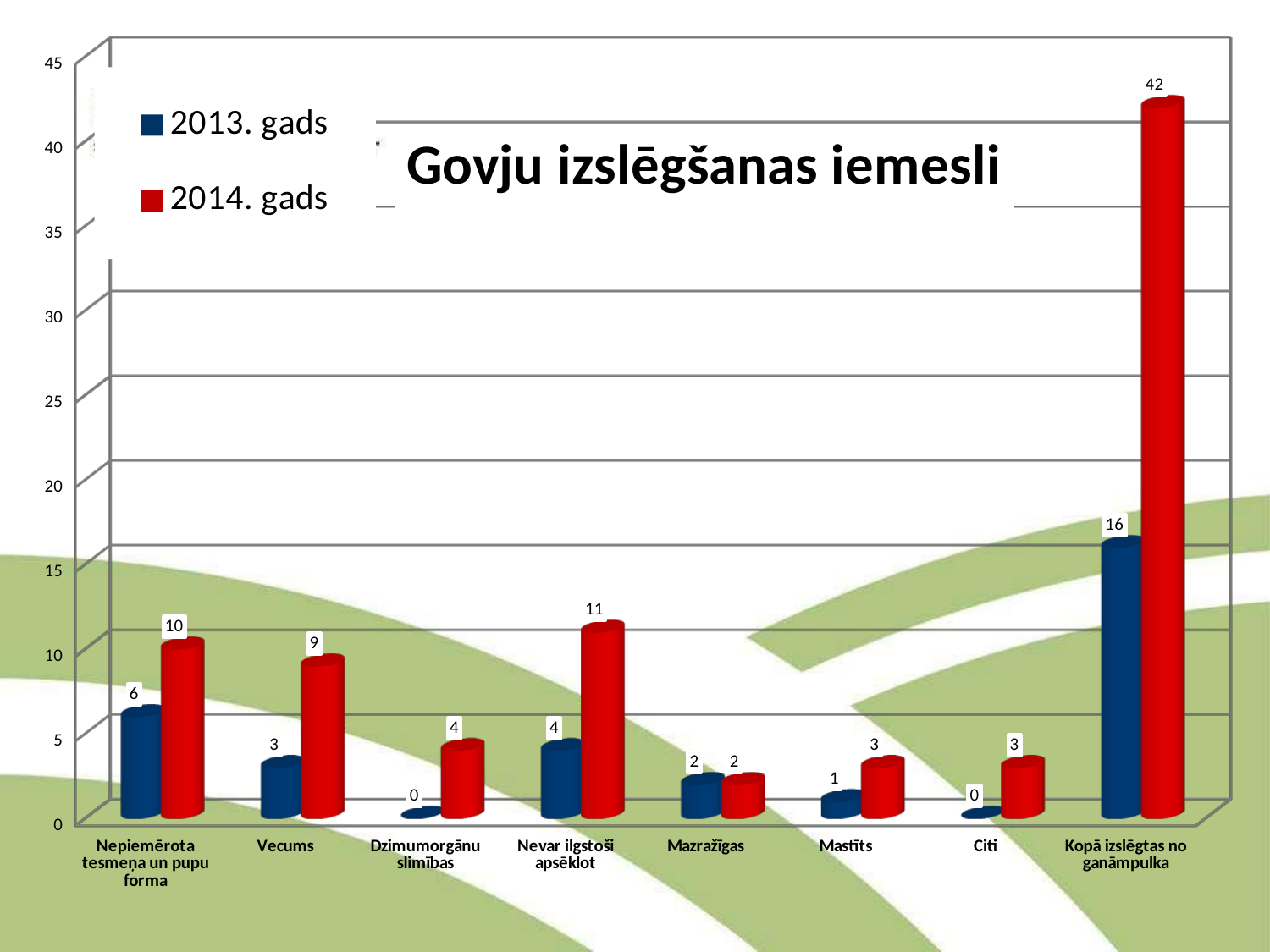
What is the value for Dzimumorgānu slimības in 2013. gads? 0 What is the difference between the 2014. gads and 2013. gads values for Kopā izslēgtas no ganāmpulka? 26 What is the value for Nevar ilgstoši apsēklot in 2013. gads? 4 What is the value for Kopā izslēgtas no ganāmpulka in 2014. gads? 42 What is the value for Vecums in 2014. gads? 9 Excluding Kopā izslēgtas no ganāmpulka, which category has the highest value for 2014. gads? Nevar ilgstoši apsēklot What kind of chart is shown on the slide? Bar chart Which is larger for Nepiemērota tesmeņa un pupu forma: the 2013. gads value or the 2014. gads value? 2014. gads What is the title of the chart? Govju izslēgšanas iemesli Which category has the highest value for 2013. gads? Kopā izslēgtas no ganāmpulka How many categories are shown on the x axis? 8 How many series does the legend list? 2